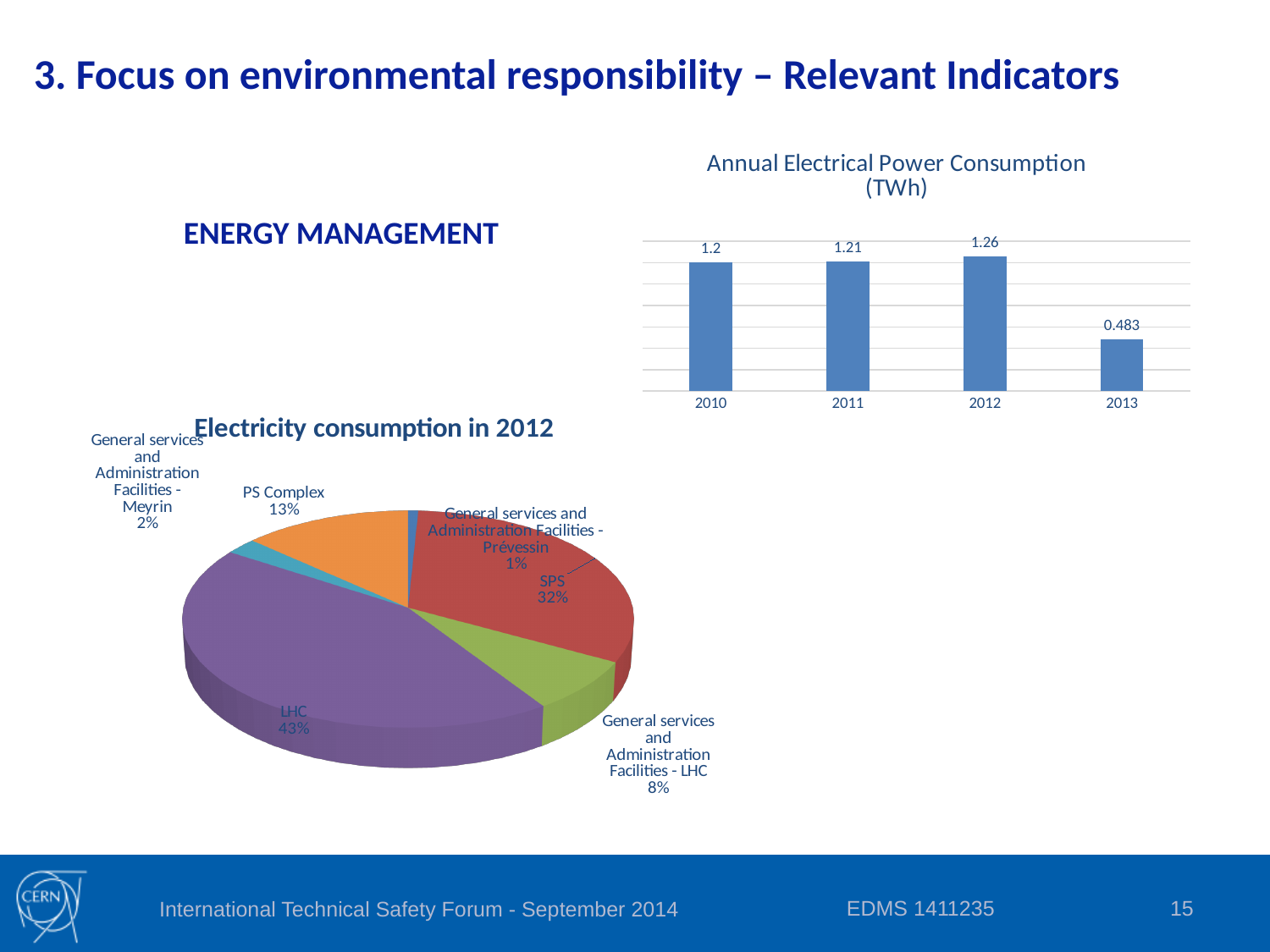
What kind of chart is the 'Annual Electrical Power Consumption (TWh)' chart? bar chart In the 'Electricity consumption in 2012' chart, which is larger: PS Complex or General services and Administration Facilities - LHC? PS Complex In the 'Annual Electrical Power Consumption (TWh)' chart, what is the value for 2013? 0.483 In the 'Electricity consumption in 2012' chart, what share does LHC have? 43% In the 'Annual Electrical Power Consumption (TWh)' chart, what is the value for 2012? 1.26 In the 'Annual Electrical Power Consumption (TWh)' chart, how many years are shown? 4 In the 'Electricity consumption in 2012' chart, which category has the largest share? LHC In the 'Electricity consumption in 2012' chart, what share does SPS have? 32% What kind of chart is the 'Electricity consumption in 2012' chart? pie chart In the 'Annual Electrical Power Consumption (TWh)' chart, which year has the highest consumption? 2012 In the 'Annual Electrical Power Consumption (TWh)' chart, what is the difference between the 2012 and 2013 values? 0.777 In the 'Annual Electrical Power Consumption (TWh)' chart, which year has the lowest consumption? 2013